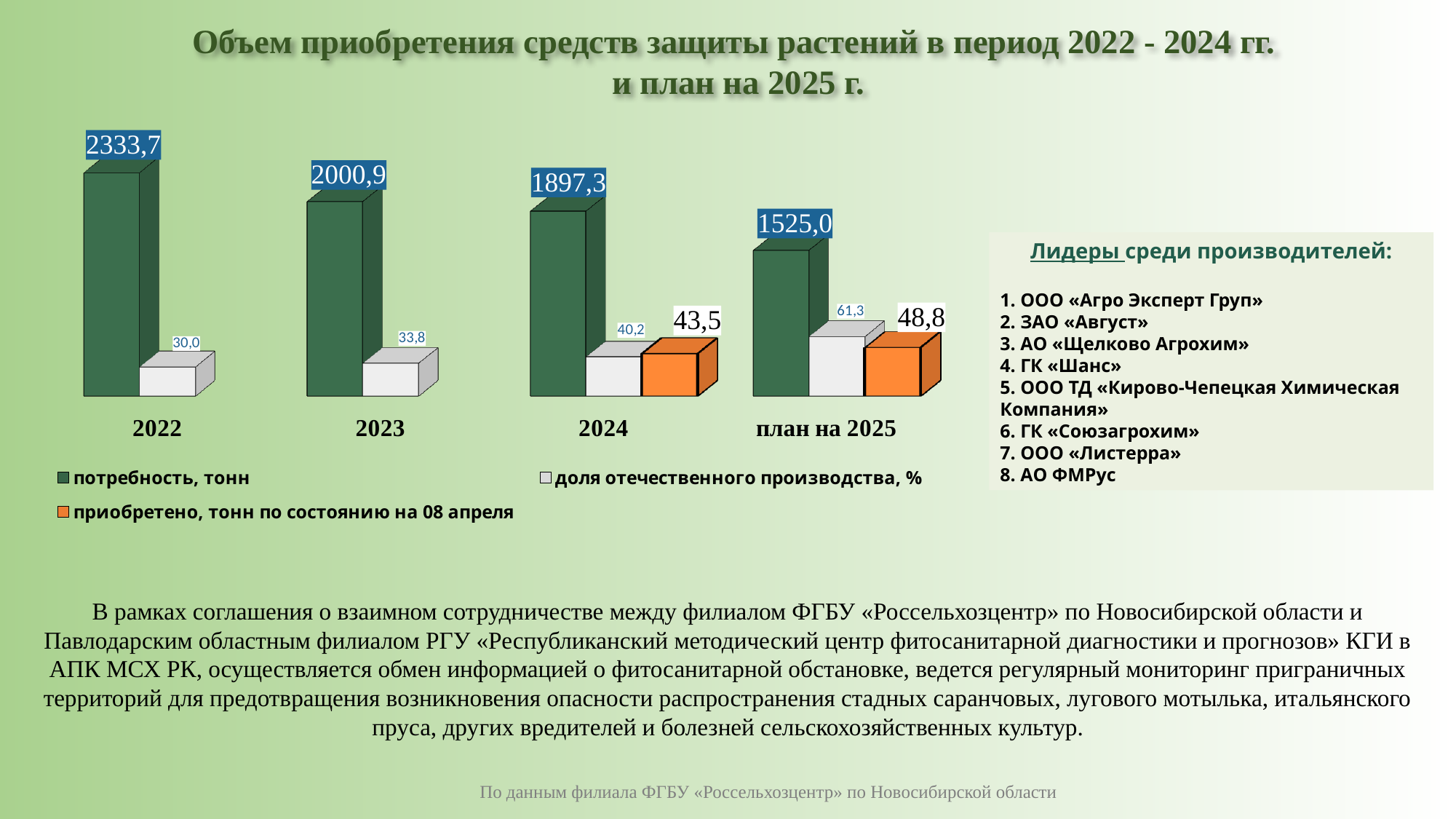
What is the value of потребность, тонн for 2022? 2333,7 Which category has the lowest value of доля отечественного производства, %? 2022 What is the difference between потребность, тонн in 2022 and in 2023? 332,8 What is the value of доля отечественного производства, % for 2024? 40,2 What kind of chart is shown on the slide? bar chart Does потребность, тонн rise or fall from 2022 to план на 2025? fall What is the value of потребность, тонн for план на 2025? 1525,0 What is the value of приобретено, тонн по состоянию на 08 апреля for план на 2025? 48,8 Which is larger: приобретено, тонн по состоянию на 08 апреля in 2024 or in план на 2025? план на 2025 How many categories are shown on the x axis? 4 How many series does the legend list? 3 Which category has the highest value of потребность, тонн? 2022